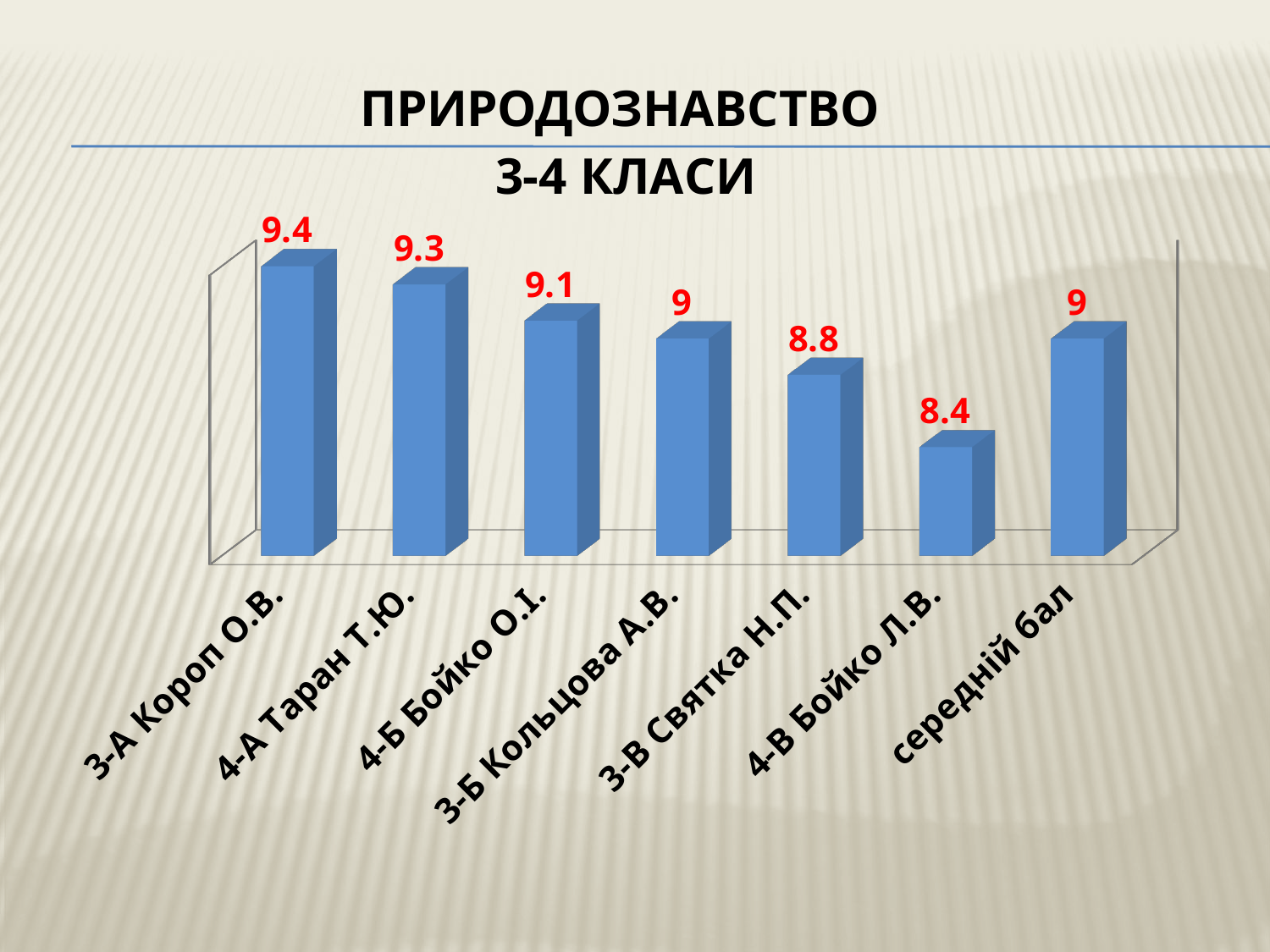
What value is shown for 3-В Святка Н.П.? 8.8 Which is larger, the value for 4-Б Бойко О.І. or the value for 3-В Святка Н.П.? 4-Б Бойко О.І. What is the difference between the values for 4-А Таран Т.Ю. and 3-В Святка Н.П.? 0.5 Which category has the lowest value? 4-В Бойко Л.В. What is the value of the середній бал bar? 9 What kind of chart is shown on the slide? Bar chart How many bars are shown in the chart? 7 What is the title of the chart? ПРИРОДОЗНАВСТВО 3-4 КЛАСИ What value is shown for 4-В Бойко Л.В.? 8.4 What value is shown for 3-А Короп О.В.? 9.4 Which category has the highest value? 3-А Короп О.В. What is the difference between the values for 3-А Короп О.В. and 4-В Бойко Л.В.? 1